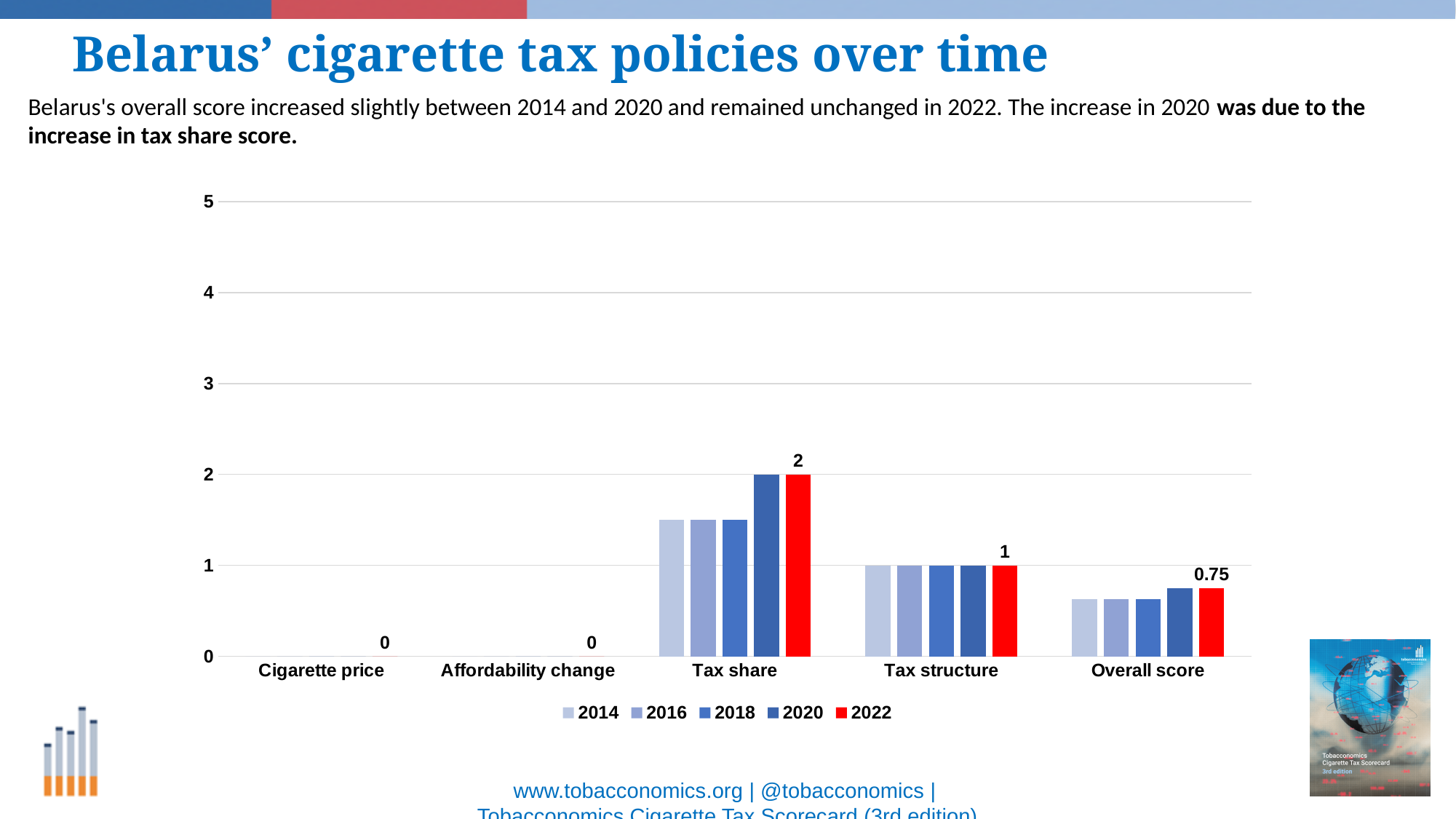
What is the difference between the 2022 values for Tax share and Tax structure? 1 Is the 2014 value for Tax share greater or less than 1? greater Which colour represents the 2022 series in the legend? Red What is the 2022 value for Affordability change? 0 How many series does the legend list? 5 How many categories are shown on the x axis? 5 Is the 2014 value for Overall score greater or less than 1? less Which category has the highest 2022 value? Tax share What is the 2022 value for Tax structure? 1 What is the 2022 value for Overall score? 0.75 What kind of chart is shown on the slide? Bar chart What is the 2022 value for Tax share? 2